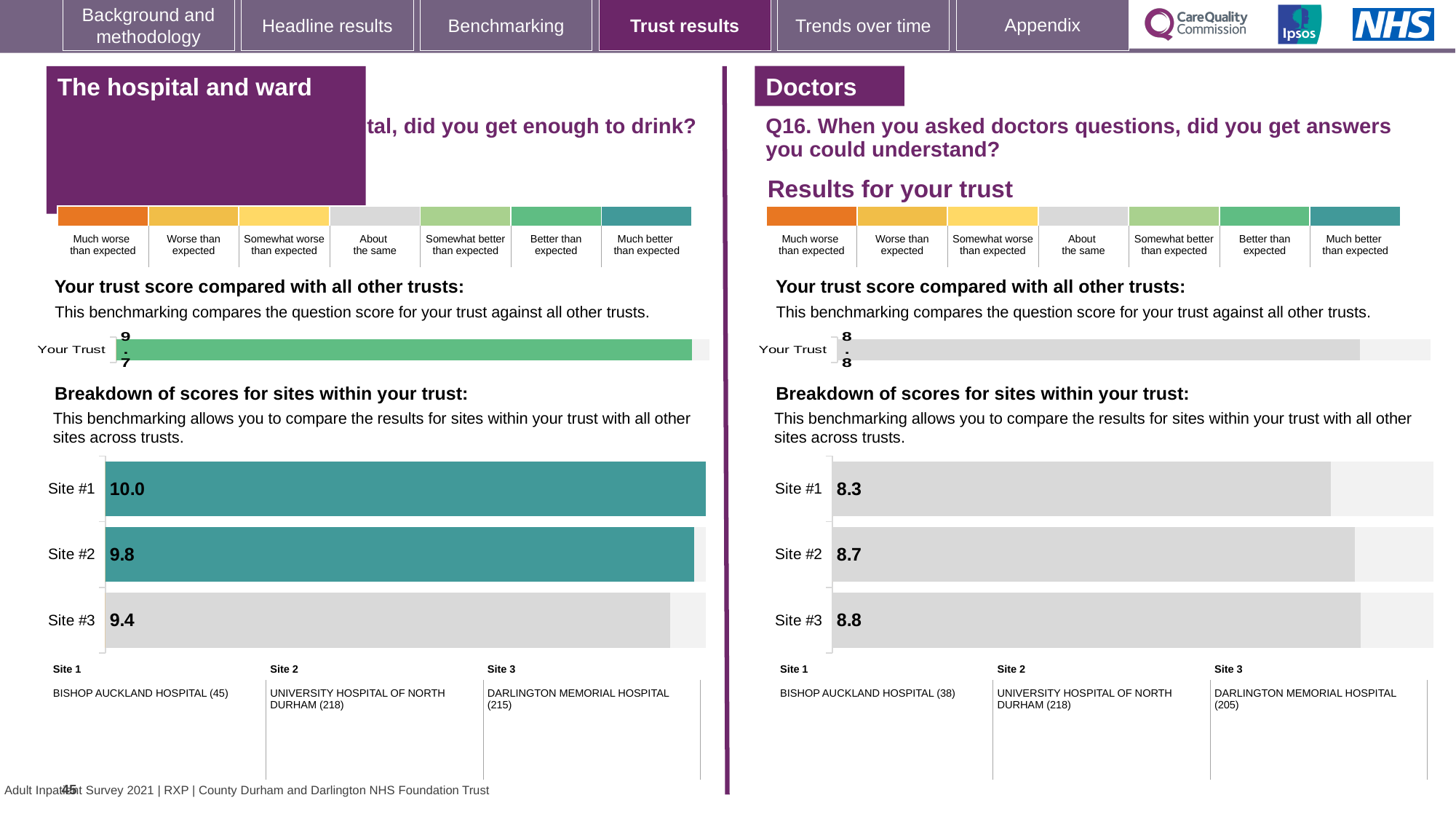
In the right-hand site breakdown chart (Doctors, Q16), which has the higher score, Site #2 or Site #3? Site #3 In the right-hand site breakdown chart (Doctors, Q16), what is the difference between the scores for Site #3 and Site #1? 0.5 What type of chart is used for the site breakdown in the Doctors (Q16) section? Bar chart How many sites are shown in the left-hand site breakdown chart (The hospital and ward section)? 3 In the left-hand site breakdown chart (The hospital and ward section), what is the difference between the scores for Site #1 and Site #3? 0.6 In the 'Your trust score compared with all other trusts' chart in the left-hand (The hospital and ward) section, what is the score for Your Trust? 9.7 In the right-hand site breakdown chart (Doctors, Q16), which site has the lowest score? Site #1 In the left-hand site breakdown chart (The hospital and ward section), which site has the highest score? Site #1 In the 'Your trust score compared with all other trusts' chart for Q16 (Doctors), what is the score for Your Trust? 8.8 In the left-hand site breakdown chart (The hospital and ward section), what is the score for Site #3? 9.4 In the right-hand site breakdown chart (Doctors, Q16), what is the score for Site #2? 8.7 In the left-hand 'Breakdown of scores for sites within your trust' chart (The hospital and ward section), what is the score for Site #1? 10.0